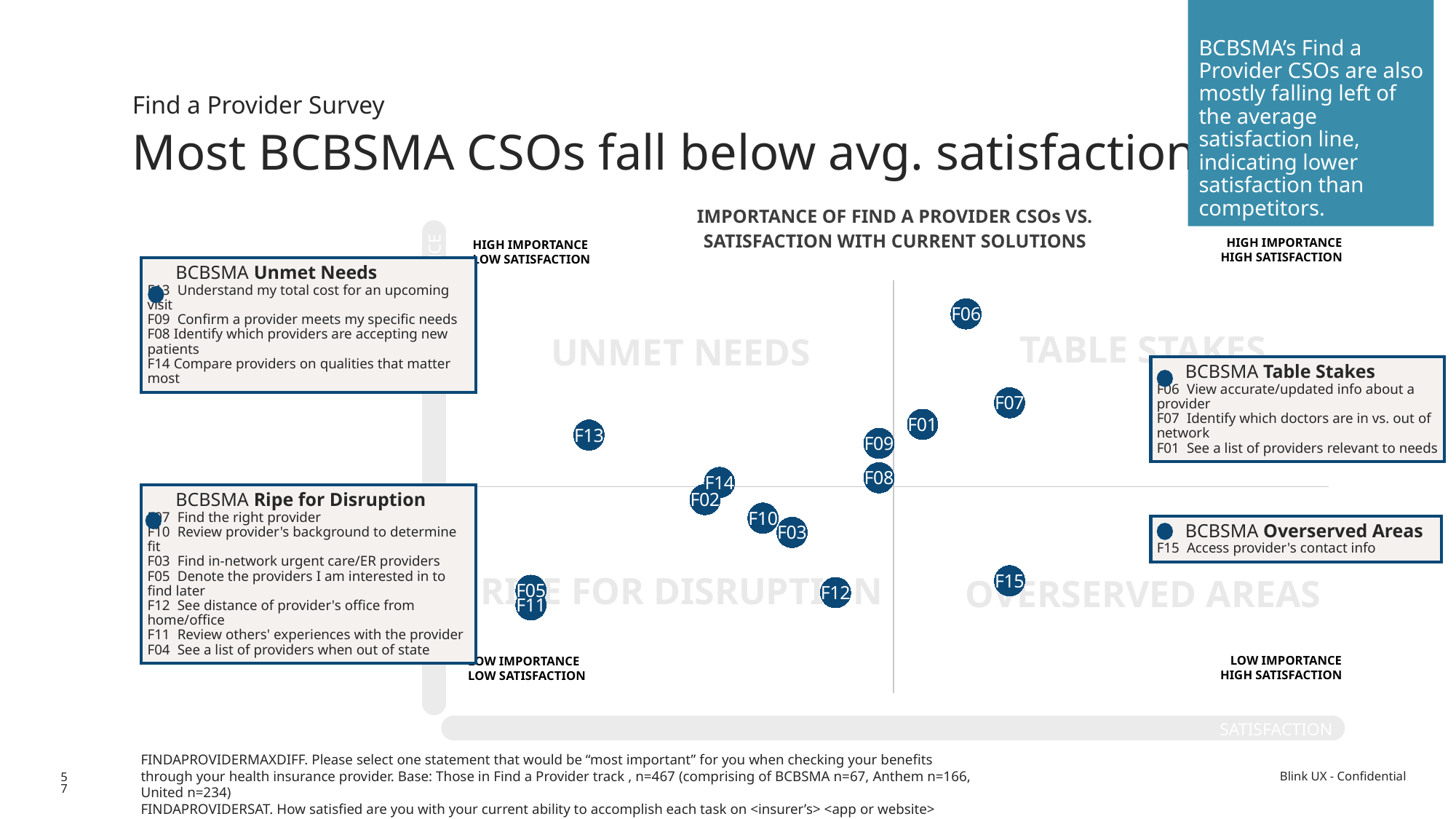
Which quadrant of the chart does F12 fall in? Ripe for Disruption What does the horizontal axis of the chart represent? Satisfaction How many points are plotted in the Overserved Areas quadrant? 1 Which point has higher satisfaction, F13 or F15? F15 Which quadrant of the chart does F13 fall in? Unmet Needs Which quadrant of the chart does F06 fall in? Table Stakes How many points are plotted in the Table Stakes quadrant? 3 Which point has higher importance, F06 or F13? F06 Which quadrant of the chart does F15 fall in? Overserved Areas What kind of chart is shown on the slide? scatter chart What is the title of the chart? IMPORTANCE OF FIND A PROVIDER CSOs VS. SATISFACTION WITH CURRENT SOLUTIONS Which point is plotted with the highest importance? F06